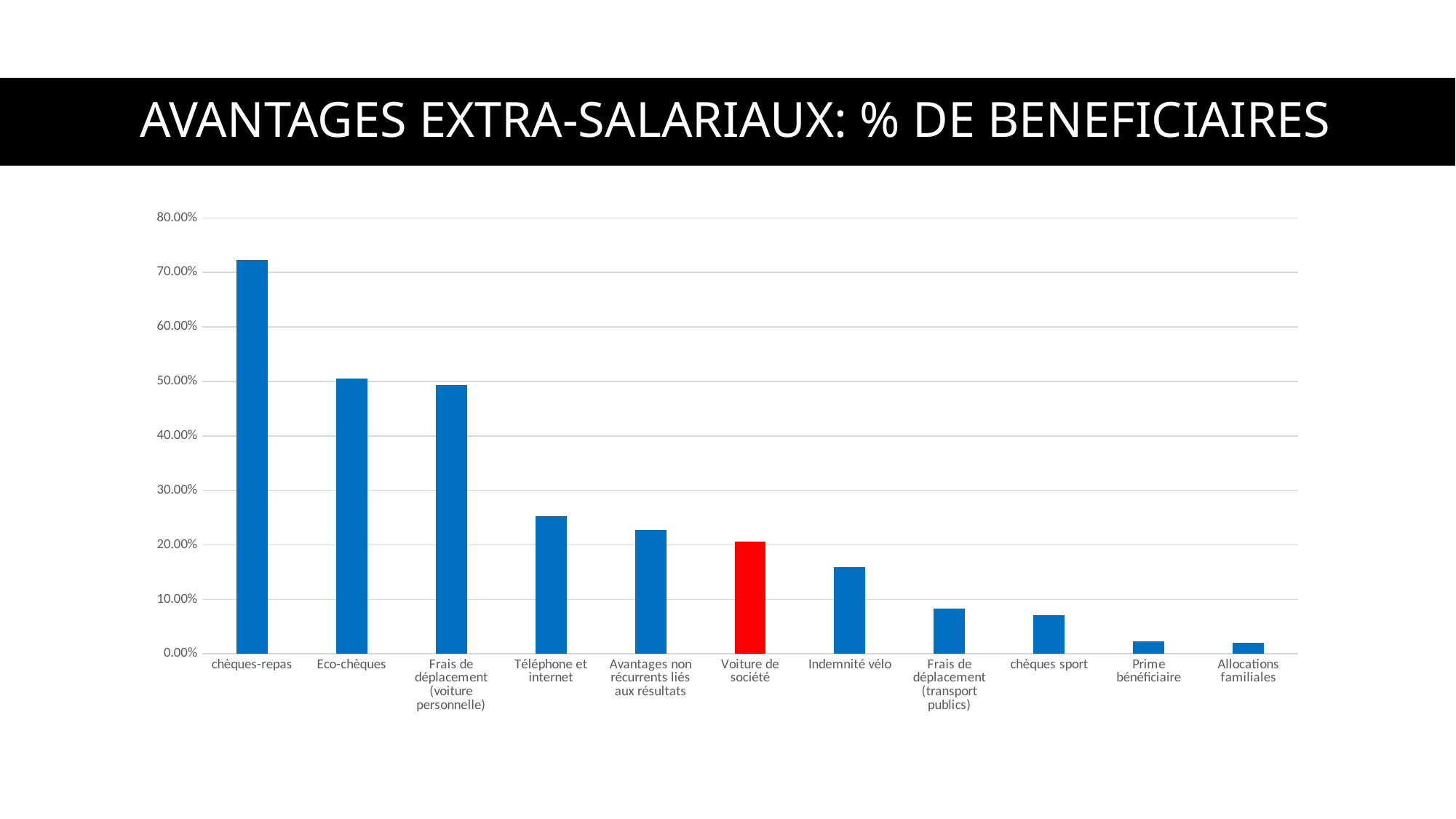
Which category's bar is coloured red instead of blue? Voiture de société Which is larger, the value for Eco-chèques or the value for Téléphone et internet? Eco-chèques What kind of chart is shown on the slide? bar chart Do the values generally rise or fall from left to right along the x axis? fall Is the value for chèques-repas greater or less than 70.00%? greater How many categories are plotted on the chart? 11 Is the value for Téléphone et internet greater or less than 30.00%? less Is the value for Indemnité vélo greater or less than 10.00%? greater Which is larger, the value for Voiture de société or the value for Indemnité vélo? Voiture de société Which category has the highest percentage of beneficiaries? chèques-repas